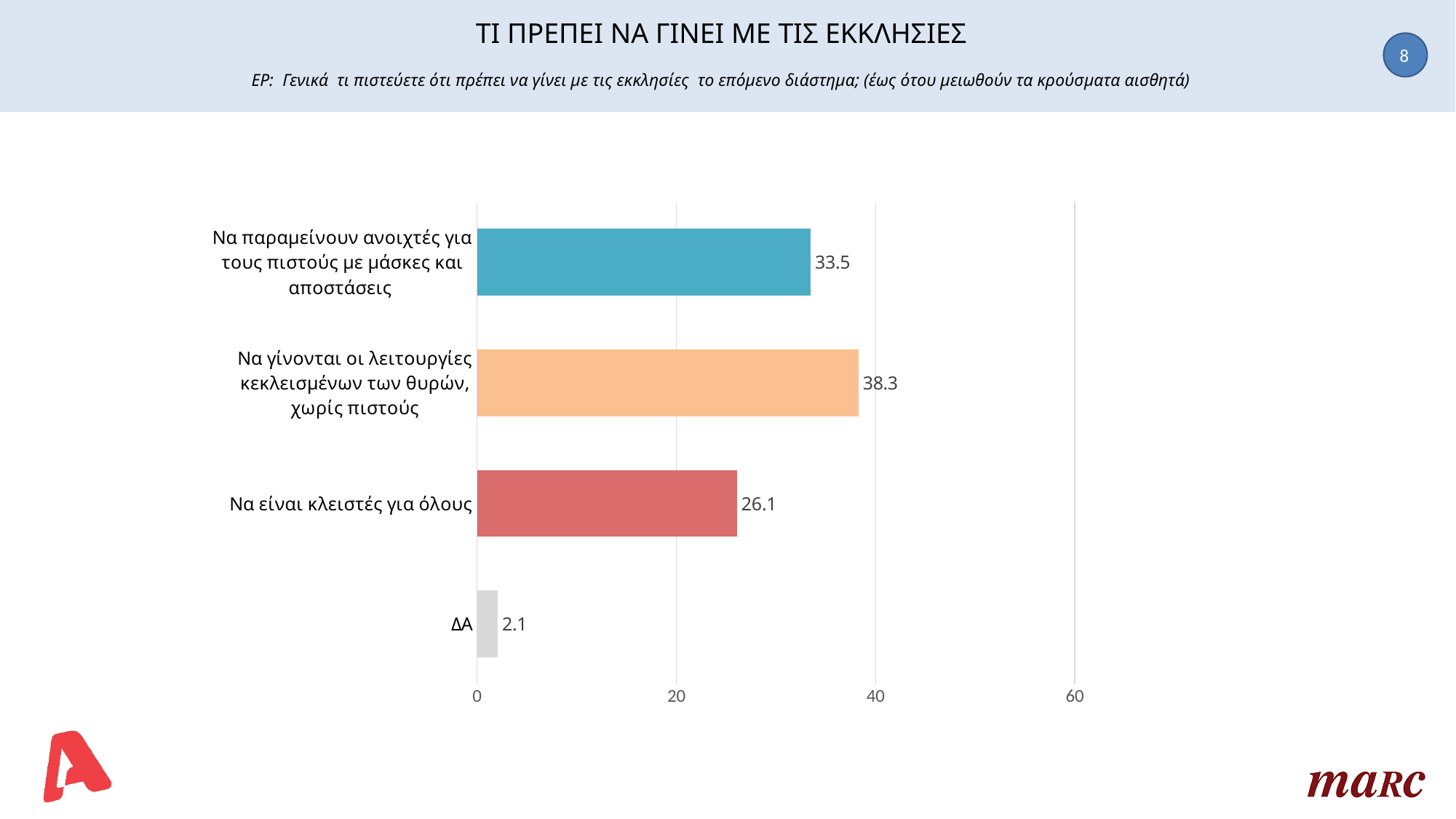
What is the value for 'Να είναι κλειστές για όλους'? 26.1 Which is larger: the value for 'Να παραμείνουν ανοιχτές για τους πιστούς με μάσκες και αποστάσεις' or for 'Να είναι κλειστές για όλους'? Να παραμείνουν ανοιχτές για τους πιστούς με μάσκες και αποστάσεις What is the value for 'Να γίνονται οι λειτουργίες κεκλεισμένων των θυρών, χωρίς πιστούς'? 38.3 Is the value for 'Να είναι κλειστές για όλους' greater or less than 20? greater What is the difference between the values for 'Να γίνονται οι λειτουργίες κεκλεισμένων των θυρών, χωρίς πιστούς' and 'Να παραμείνουν ανοιχτές για τους πιστούς με μάσκες και αποστάσεις'? 4.8 What is the value for 'Να παραμείνουν ανοιχτές για τους πιστούς με μάσκες και αποστάσεις'? 33.5 What is the title of the slide? ΤΙ ΠΡΕΠΕΙ ΝΑ ΓΙΝΕΙ ΜΕ ΤΙΣ ΕΚΚΛΗΣΙΕΣ Which category has the lowest value? ΔΑ What kind of chart is shown on the slide? bar chart What is the value for 'ΔΑ'? 2.1 How many categories are shown in the chart? 4 Which category has the highest value? Να γίνονται οι λειτουργίες κεκλεισμένων των θυρών, χωρίς πιστούς